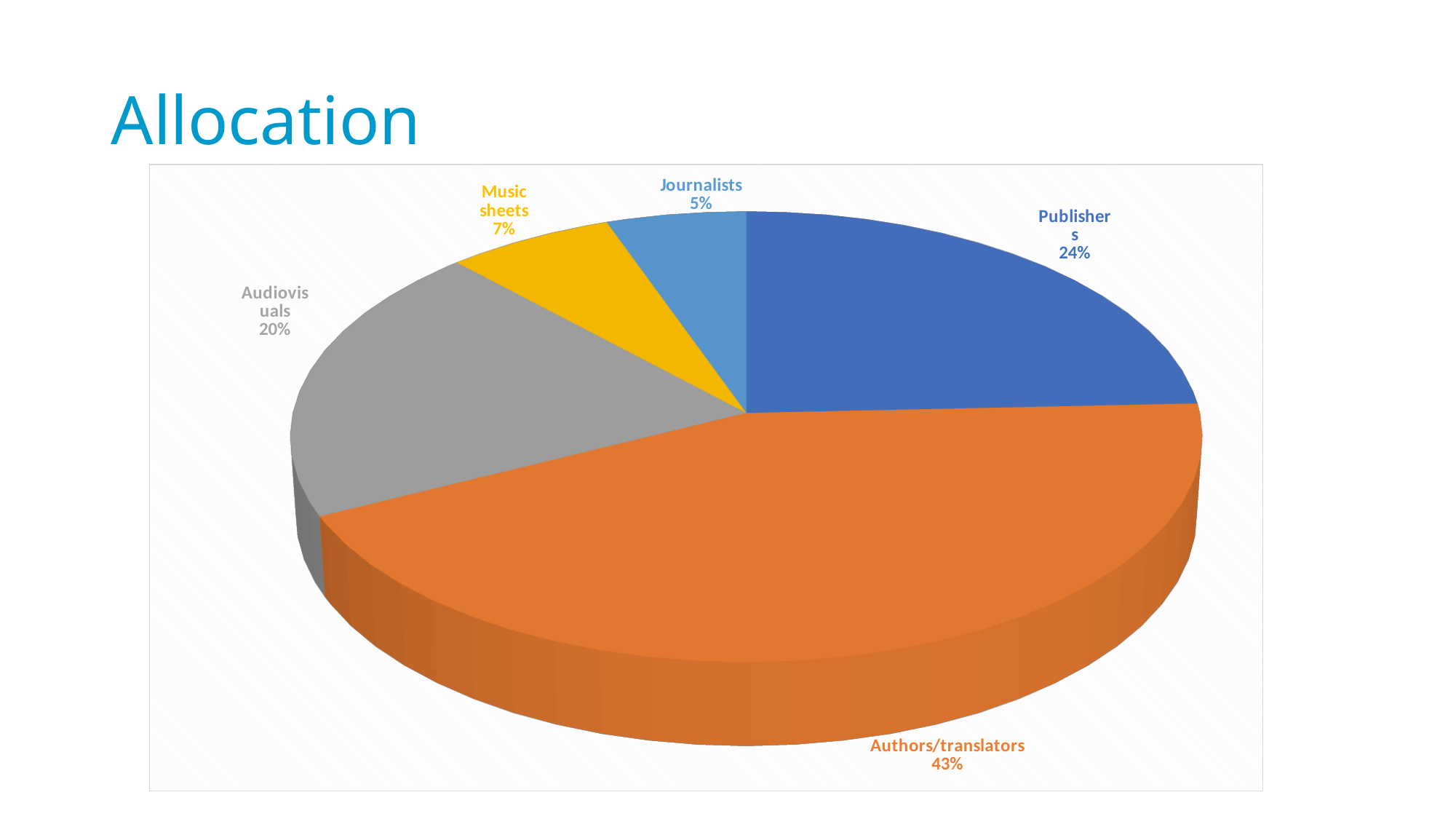
Which category has the largest slice of the pie? Authors/translators Which is larger, the share for Publishers or the share for Audiovisuals? Publishers How many categories are shown in the pie chart? 5 What share of the pie does Authors/translators have? 43% What share of the pie does Music sheets have? 7% What is the difference in percentage points between Authors/translators and Publishers? 19 What kind of chart is shown on the slide? Pie chart What is the difference in percentage points between Audiovisuals and Music sheets? 13 What share of the pie does Audiovisuals have? 20% Which category has the smallest slice of the pie? Journalists